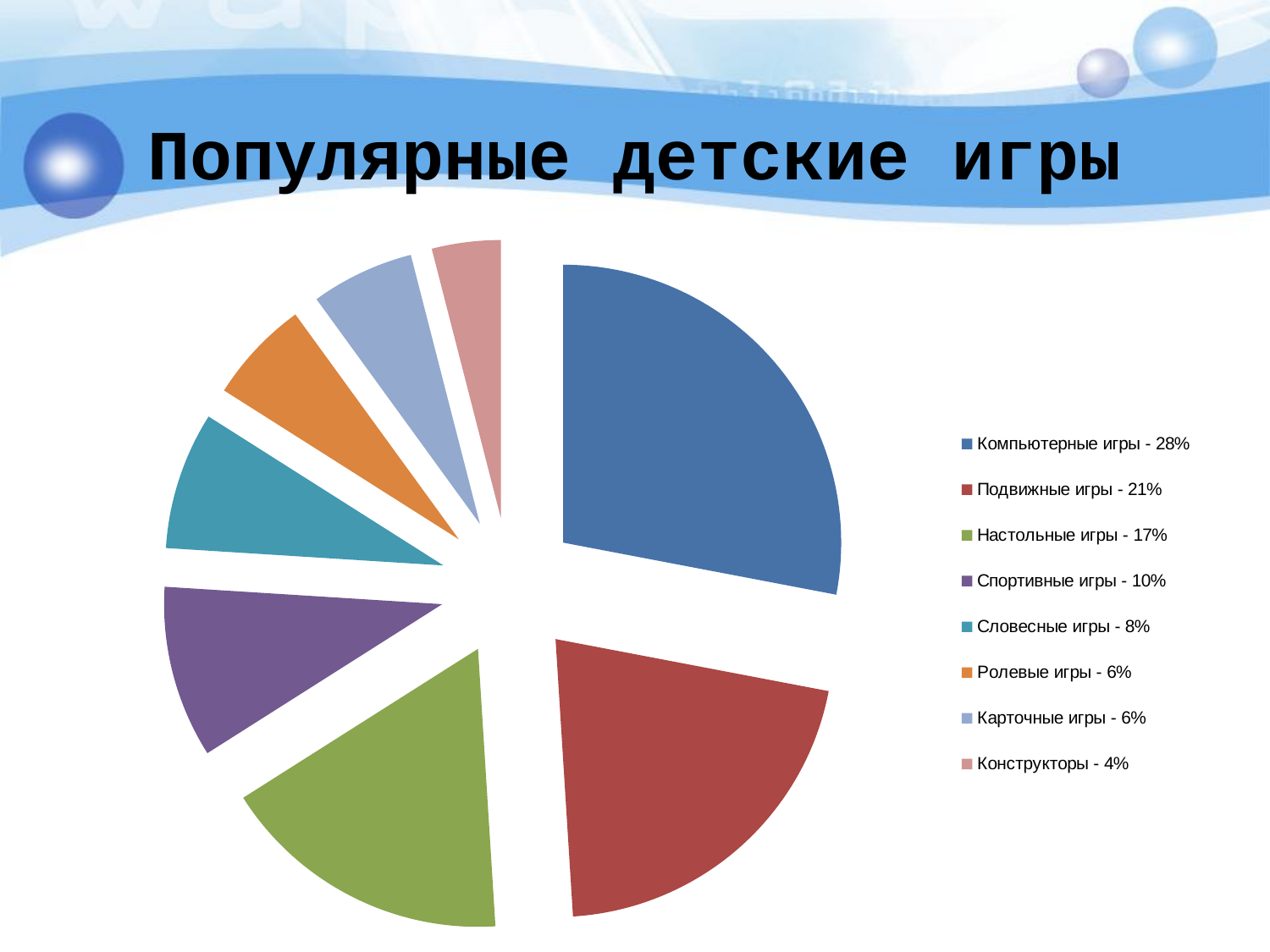
What percentage is shown for Словесные игры? 8% What percentage is shown for Подвижные игры? 21% What percentage is shown for Настольные игры? 17% What percentage is shown for Карточные игры? 6% What kind of chart is shown on the slide? Pie chart What is the title of the chart on the slide? Популярные детские игры Which category has the largest share of the pie? Компьютерные игры Which is larger, the share for Спортивные игры or the share for Словесные игры? Спортивные игры What is the difference in percentage points between Компьютерные игры and Подвижные игры? 7 Which category has the smallest share of the pie? Конструкторы What share of the pie is Компьютерные игры? 28% How many categories does the pie chart have? 8